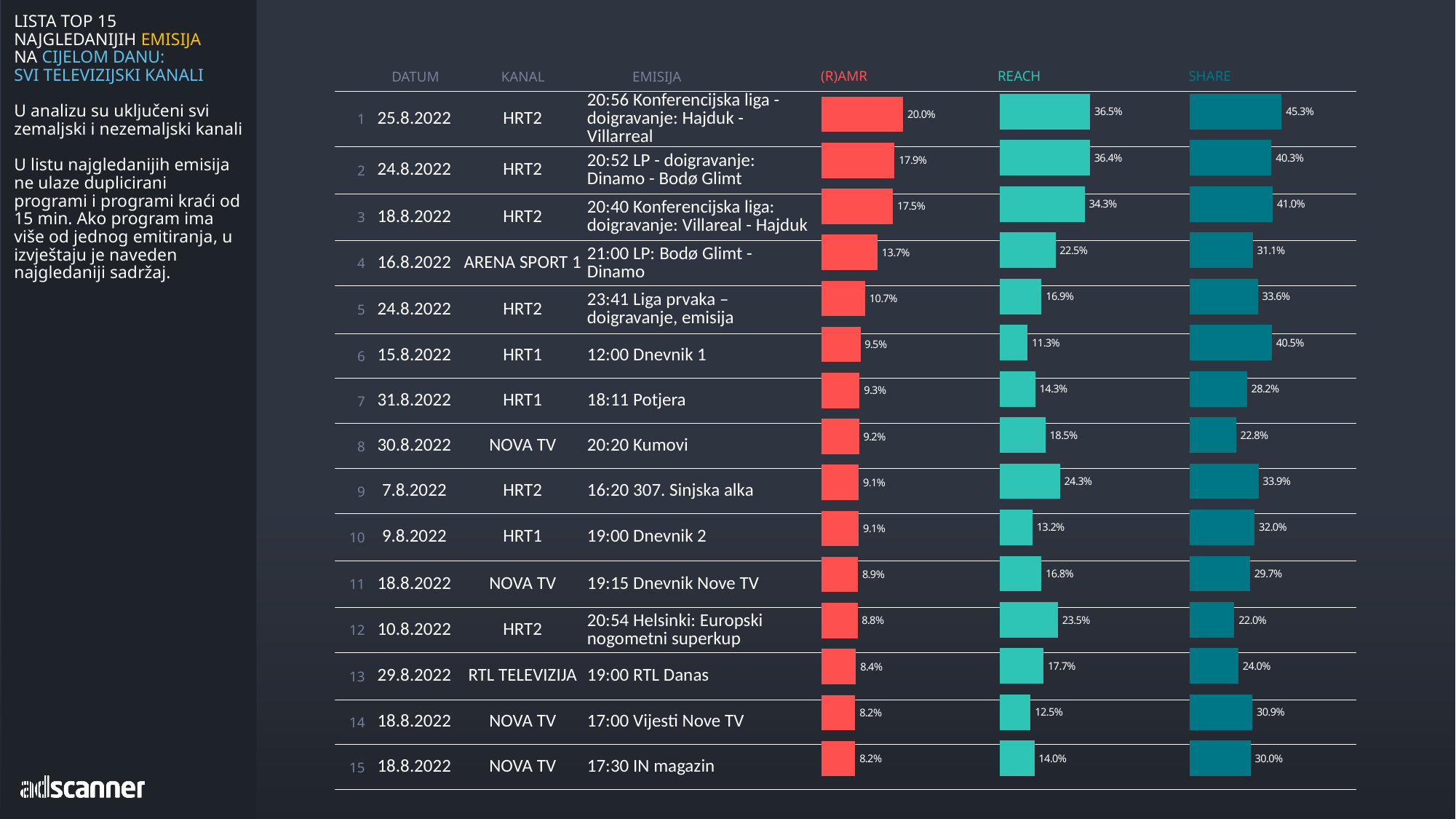
What is the SHARE value for 19:00 RTL Danas? 24.0% What is the (R)AMR value for 12:00 Dnevnik 1? 9.5% What is the difference in (R)AMR between 20:56 Konferencijska liga - doigravanje: Hajduk - Villarreal and 20:52 LP - doigravanje: Dinamo - Bodø Glimt? 2.1% Do the (R)AMR values rise or fall going down the list from rank 1 to rank 15? Fall Which programme has the lowest REACH value? 12:00 Dnevnik 1 How many programmes are listed in the chart? 15 What colour are the bars in the REACH column? Teal (light green-blue) Which programme has the highest (R)AMR value? 20:56 Konferencijska liga - doigravanje: Hajduk - Villarreal Which has a higher REACH value: 16:20 307. Sinjska alka or 19:00 Dnevnik 2? 16:20 307. Sinjska alka Which programme has the lowest SHARE value? 20:54 Helsinki: Europski nogometni superkup What is the REACH value for 20:20 Kumovi? 18.5% What kind of chart is used to show the (R)AMR, REACH and SHARE values? Bar chart